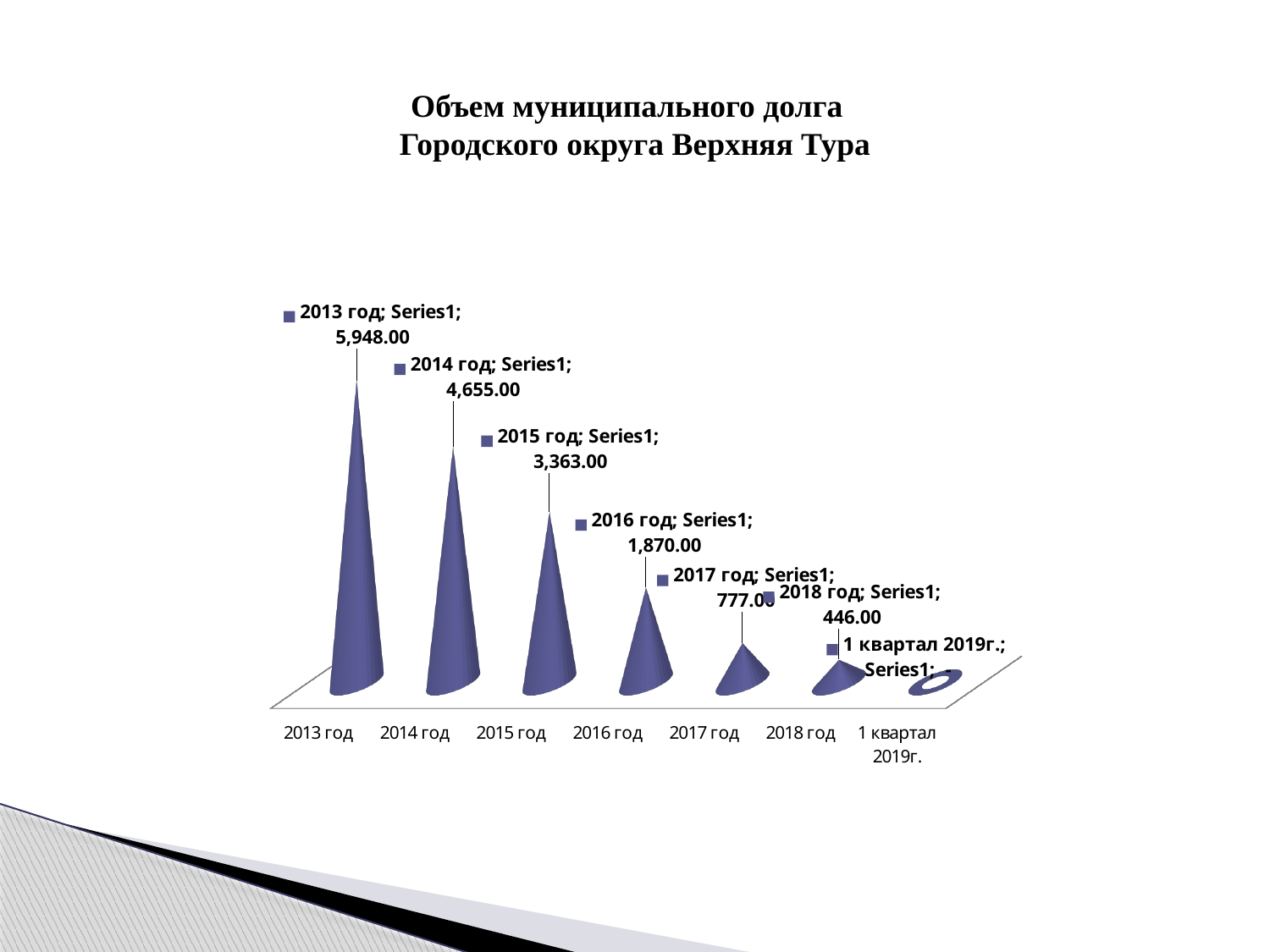
What is the difference between the values for 2013 год and 2014 год? 1,293.00 What is the value for 2014 год? 4,655.00 Which category has the lowest value? 1 квартал 2019г. How many categories are shown on the x axis? 7 Which is larger, the value for 2016 год or the value for 2018 год? 2016 год What is the value for 2015 год? 3,363.00 Do the values rise or fall from 2013 год to 1 квартал 2019г.? fall What is the value for 2013 год? 5,948.00 What is the value for 2018 год? 446.00 Which category has the highest value? 2013 год What is the difference between the values for 2015 год and 2016 год? 1,493.00 What is the value for 2016 год? 1,870.00